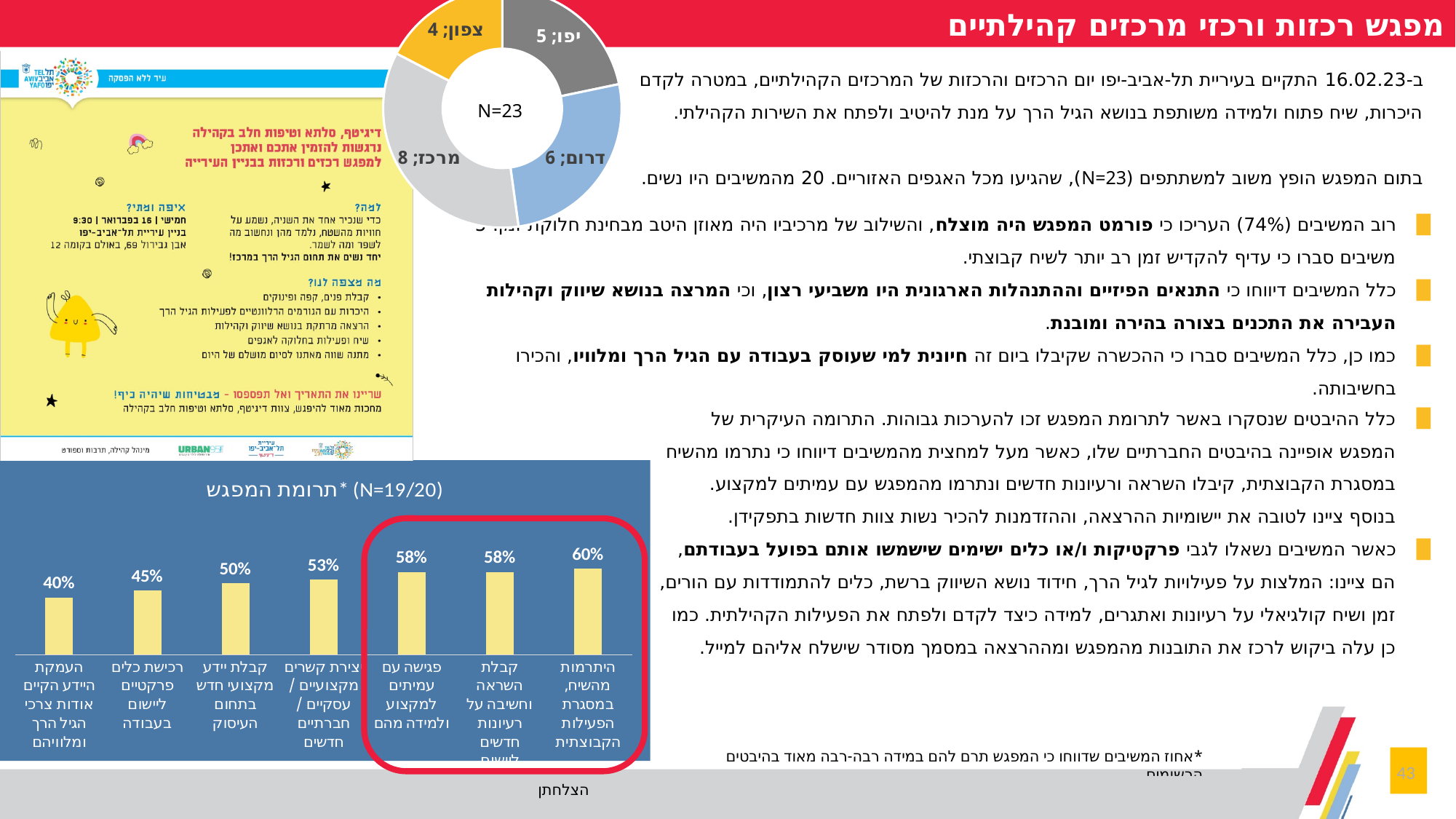
In the bar chart titled תרומת המפגש, how many bars are shown? 7 In the bar chart titled תרומת המפגש, what is the difference between the highest and lowest values? 20% In the bar chart titled תרומת המפגש, what is the value for העמקת הידע הקיים אודות צרכי הגיל הרך ומלוויהם? 40% In the donut chart at the top of the slide, what is the value for מרכז? 8 In the donut chart at the top of the slide, what is the value for צפון? 4 In the donut chart at the top of the slide, which region has the smallest value? צפון In the bar chart titled תרומת המפגש, what is the value for היתרמות מהשיח, במסגרת הפעילות הקבוצתית? 60% In the donut chart at the top of the slide, which region has the largest value? מרכז In the donut chart at the top of the slide, what is the difference between the values for דרום and יפו? 1 In the donut chart at the top of the slide, what is the total N shown in the centre? N=23 In the bar chart titled תרומת המפגש, which is larger: the value for קבלת ידע מקצועי חדש בתחום העיסוק or the value for רכישת כלים פרקטיים ליישום בעבודה? קבלת ידע מקצועי חדש בתחום העיסוק What kind of chart is the chart titled תרומת המפגש? bar chart